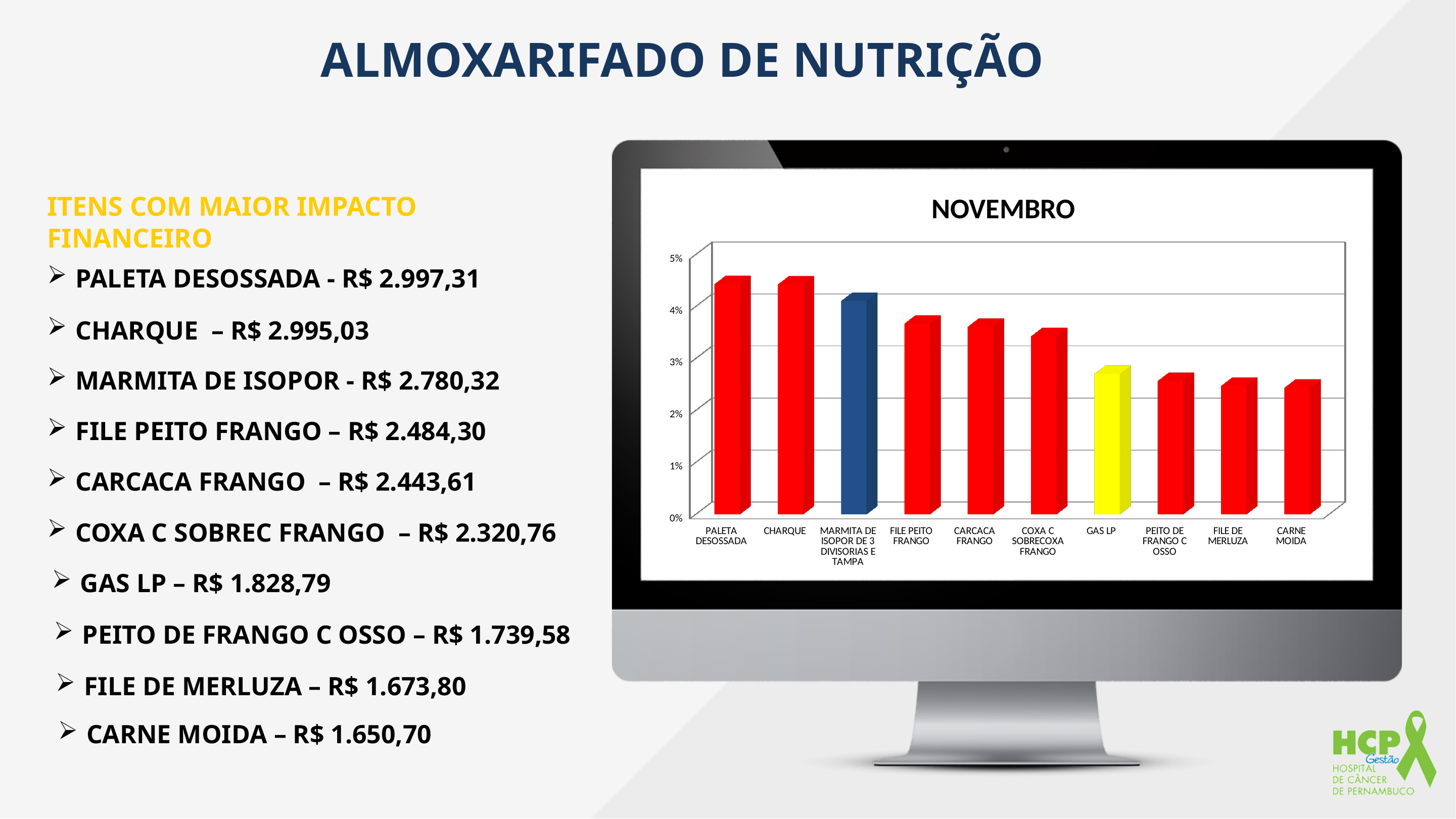
How many categories are plotted in the chart? 10 Is the value for FILE PEITO FRANGO greater or less than 4%? less Which has the larger value, PALETA DESOSSADA or GAS LP? PALETA DESOSSADA Is the value for COXA C SOBRECOXA FRANGO greater or less than 3%? greater Is the value for GAS LP greater or less than 3%? less Which category's bar is coloured yellow? GAS LP Do the bar values generally rise or fall from left to right along the x axis? fall What is the title of the chart? NOVEMBRO What kind of chart is shown on the slide? bar chart Which has the larger value, CARNE MOIDA or MARMITA DE ISOPOR DE 3 DIVISORIAS E TAMPA? MARMITA DE ISOPOR DE 3 DIVISORIAS E TAMPA